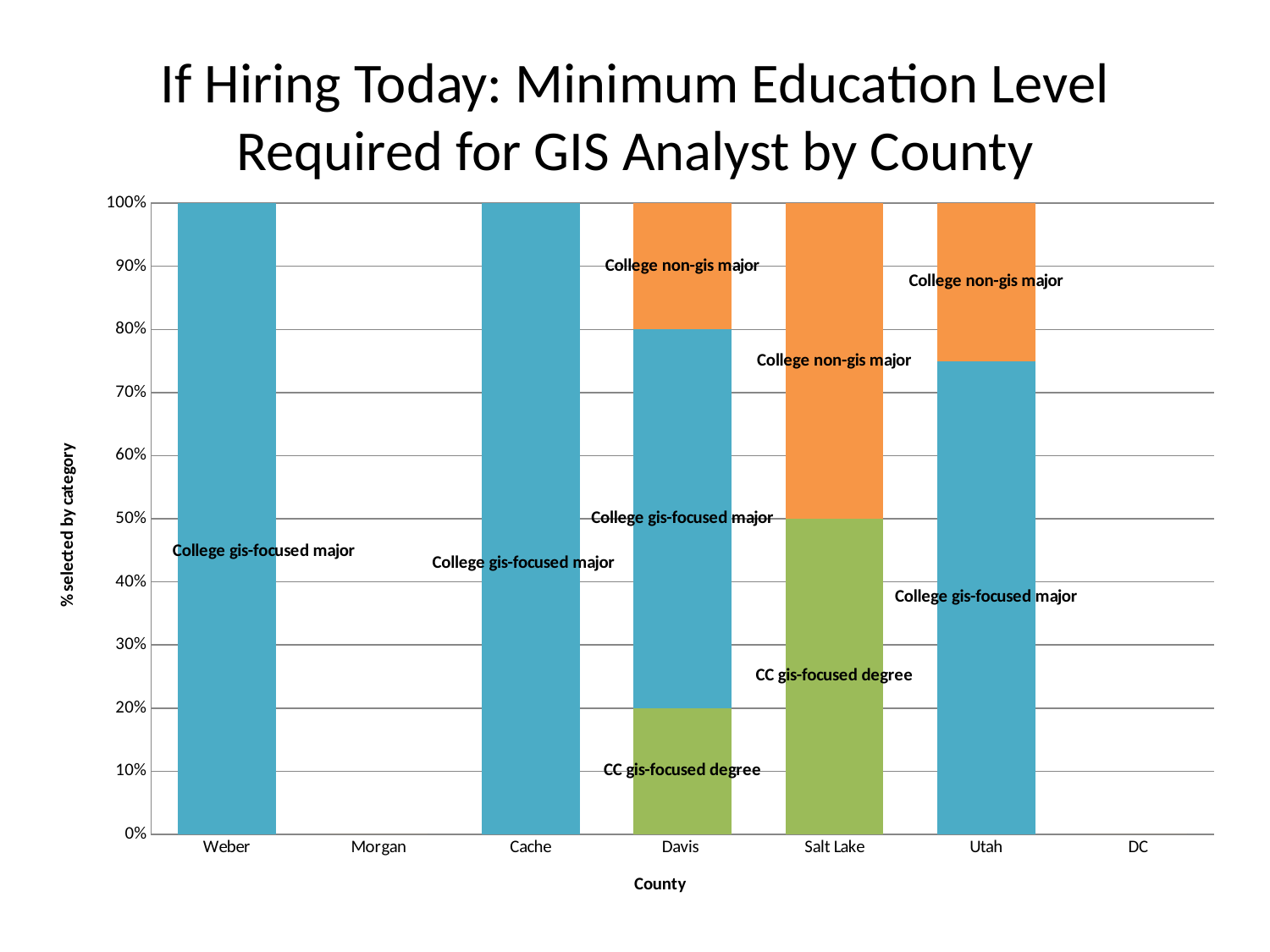
What percentage of the Weber bar is College gis-focused major? 100% What percentage of the Salt Lake bar is CC gis-focused degree? 50% What percentage of the Davis bar is CC gis-focused degree? 20% Is the College non-gis major share for Utah greater or less than 30%? less How many counties are listed along the x axis? 7 What percentage of the Davis bar is College gis-focused major? 60% Is the College gis-focused major share for Utah greater or less than 70%? greater Which county has the larger CC gis-focused degree share, Davis or Salt Lake? Salt Lake Which county has the largest CC gis-focused degree share? Salt Lake What is the title of the y axis? % selected by category What kind of chart is shown on the slide? Stacked bar chart Which counties on the x axis have no bar plotted? Morgan and DC